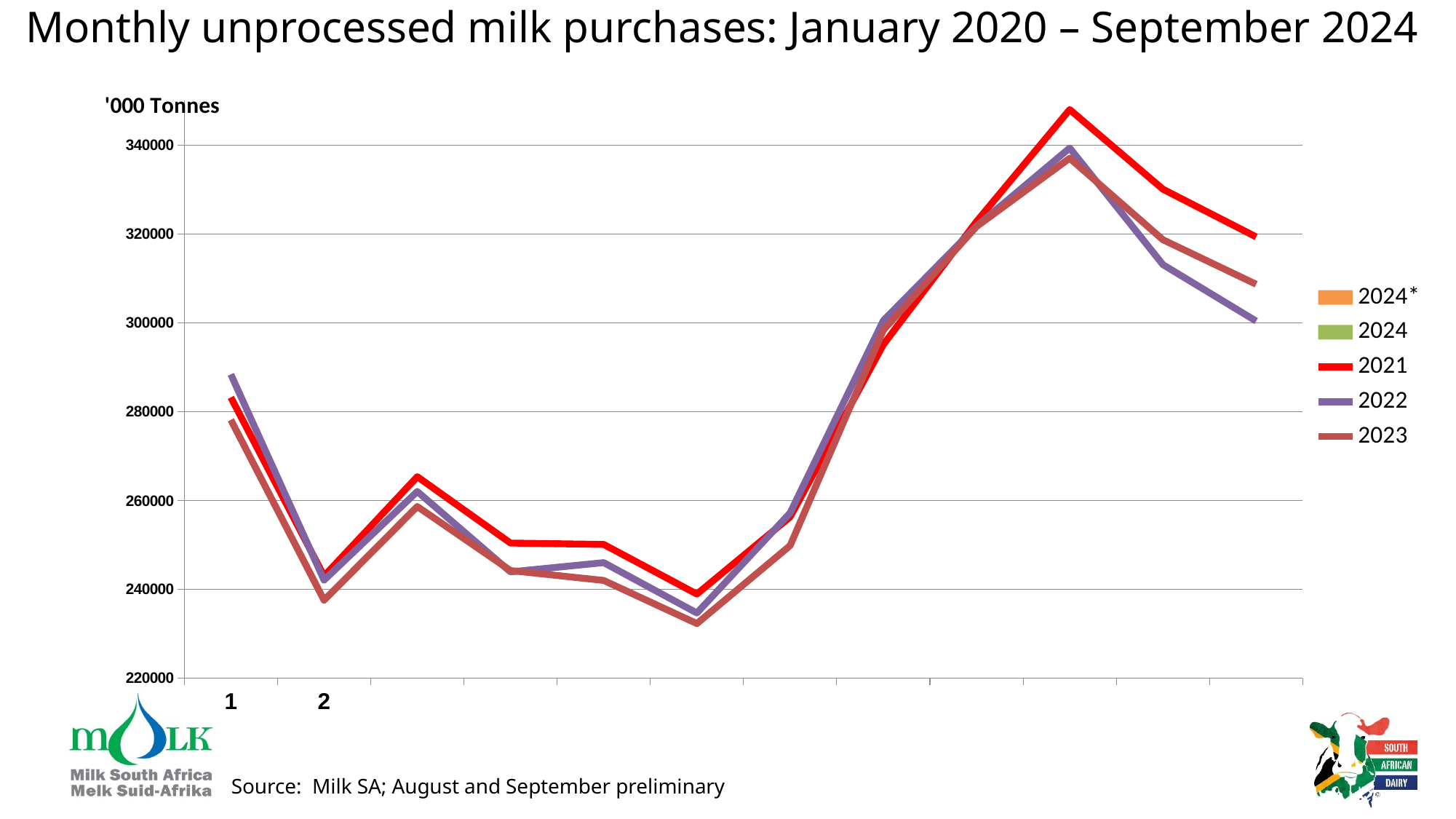
Do the values rise or fall from x-axis position 1 to position 2 for the 2021 series? fall Which series reaches the highest peak on the chart? 2021 How many series does the legend list? 5 What is the title of the chart? Monthly unprocessed milk purchases: January 2020 – September 2024 Is the value for 2022 at x-axis position 1 greater or less than 280000? greater Is the value for 2021 at x-axis position 2 greater or less than 240000? greater What unit label is shown above the vertical axis? '000 Tonnes At x-axis position 2, which series has the larger value, 2021 or 2023? 2021 At x-axis position 1, which series has the larger value, 2021 or 2022? 2022 How many points are plotted along the x axis for each series? 12 Is the value for 2023 at x-axis position 2 greater or less than 240000? less What kind of chart is shown on the slide? line chart